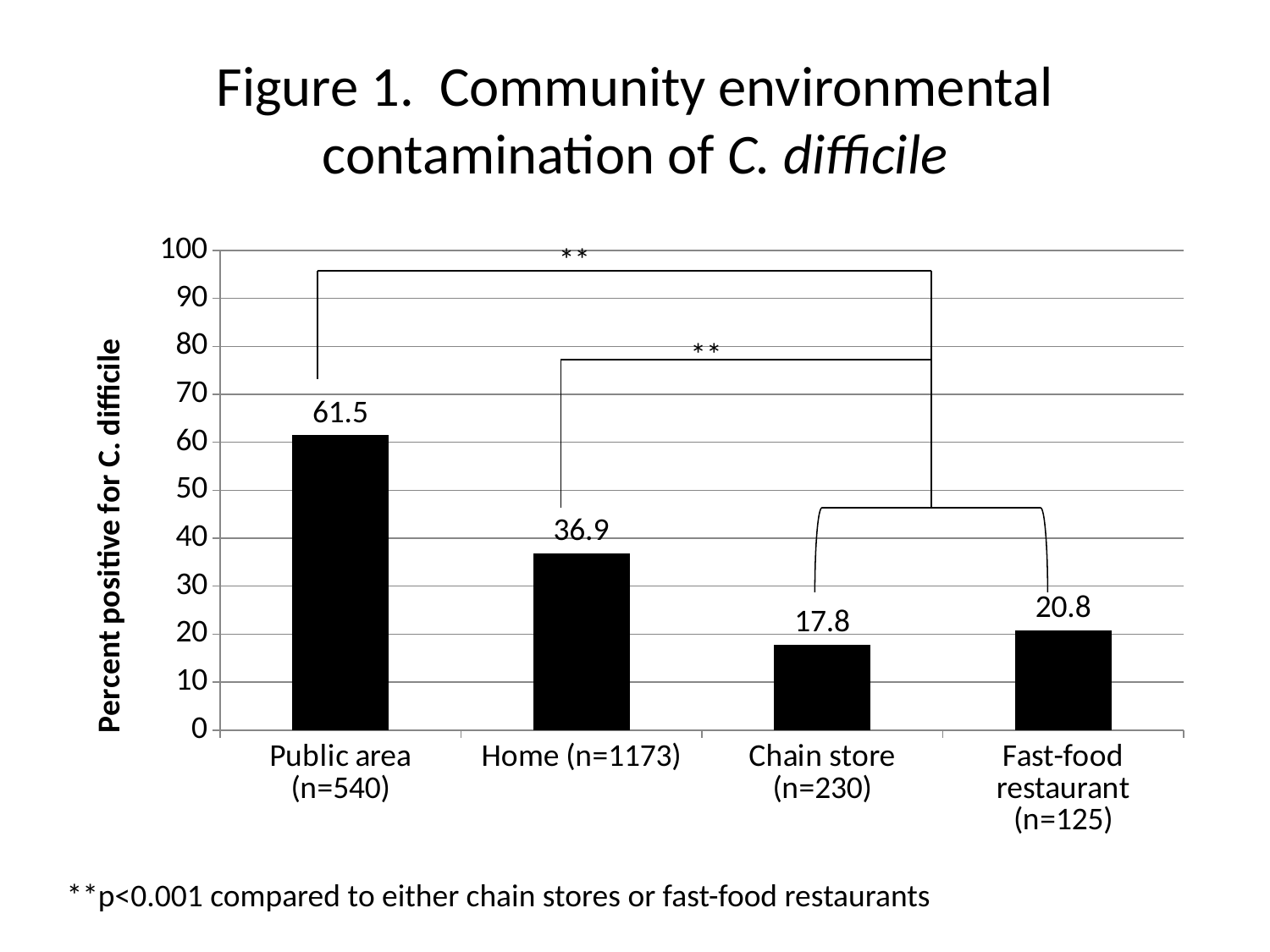
What is the percent positive for C. difficile for Home (n=1173)? 36.9 What is the percent positive for C. difficile for Chain store (n=230)? 17.8 Which has a higher percent positive for C. difficile, Home (n=1173) or Fast-food restaurant (n=125)? Home (n=1173) Which category has the highest percent positive for C. difficile? Public area (n=540) What is the percent positive for C. difficile for Fast-food restaurant (n=125)? 20.8 What is the label of the y axis? Percent positive for C. difficile What is the difference in percent positive between Public area (n=540) and Home (n=1173)? 24.6 How many categories are shown on the x axis? 4 What is the difference in percent positive between Fast-food restaurant (n=125) and Chain store (n=230)? 3.0 Which category has the lowest percent positive for C. difficile? Chain store (n=230) What kind of chart is shown on the slide? Bar chart What is the percent positive for C. difficile for Public area (n=540)? 61.5